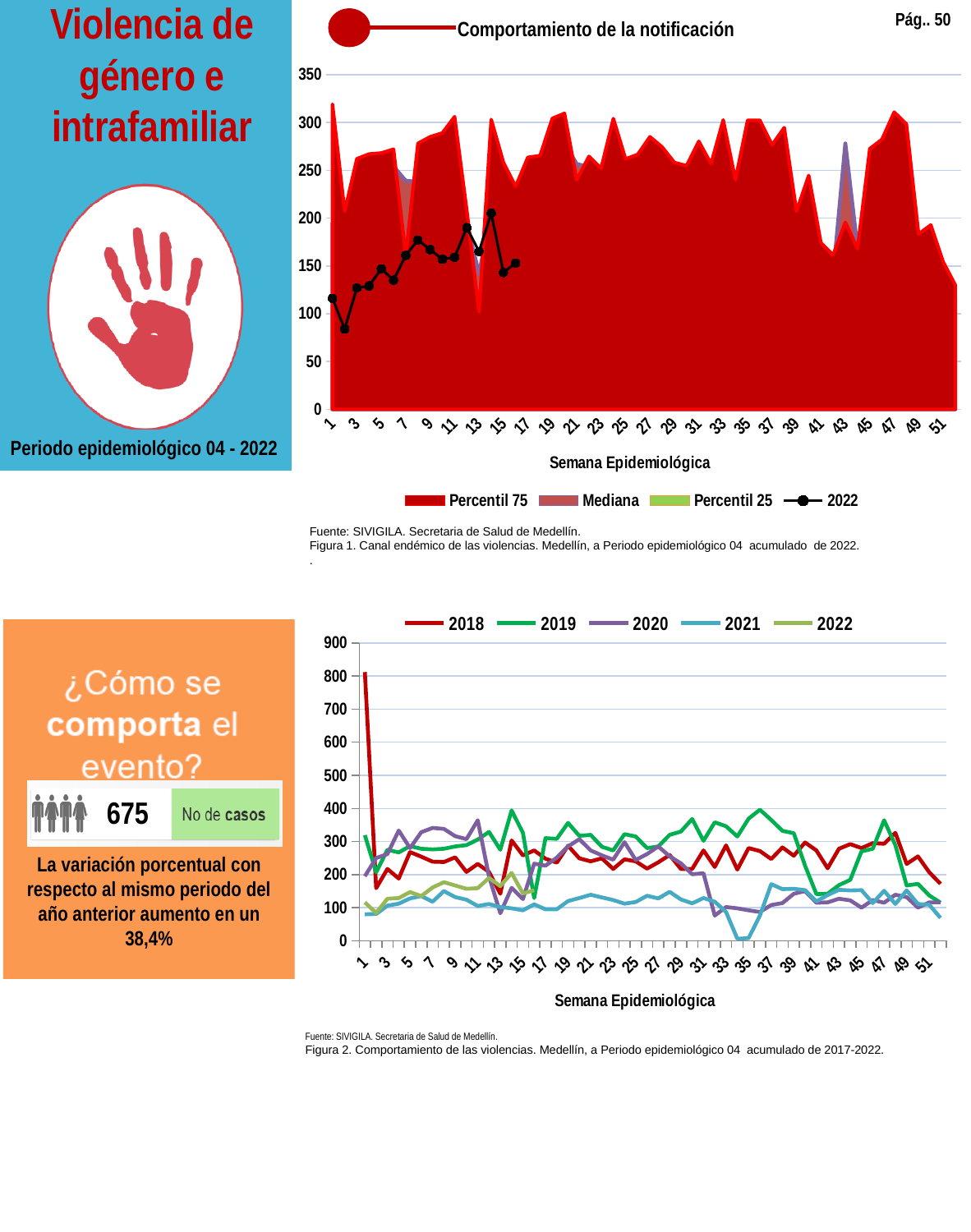
In the top chart 'Comportamiento de la notificación', is the Percentil 75 value at week 1 greater or less than 300? greater How many series does the legend of the bottom chart list? 5 In the top chart 'Comportamiento de la notificación', is the 2022 value at week 2 greater or less than 100? less What kind of chart is the top chart titled 'Comportamiento de la notificación'? area chart In the bottom chart, at week 35, which is larger: the 2019 value or the 2021 value? 2019 In the top chart 'Comportamiento de la notificación', what is the label of the x axis? Semana Epidemiológica In the bottom chart, what colour is the line for 2020? purple What kind of chart is the bottom chart showing the years 2018 to 2022? line chart How many series does the legend of the top chart 'Comportamiento de la notificación' list? 4 In the bottom chart, is the 2018 value at week 1 greater or less than 700? greater In the bottom chart, which series has the highest value at week 1? 2018